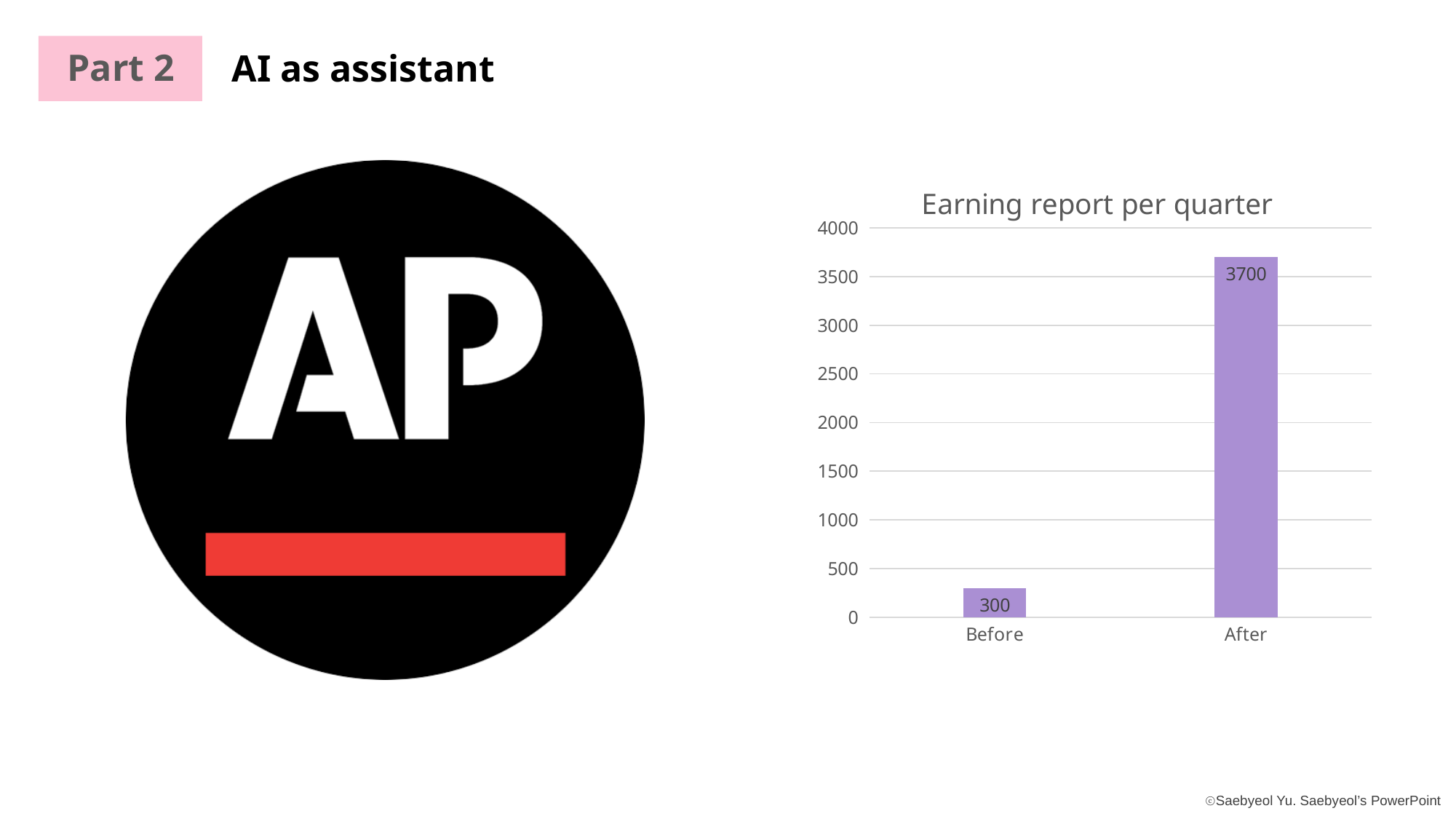
How many categories are shown on the x axis? 2 What is the difference between the After and Before values? 3400 What is the title of the chart? Earning report per quarter Is the value for After greater or less than 3500? greater Do the values rise or fall from Before to After? rise Which category has the highest value? After What kind of chart is shown on the slide? bar chart What is the value for After? 3700 Which category has the lowest value? Before Which is larger, the value for Before or the value for After? After What is the value for Before? 300 Is the value for Before greater or less than 500? less